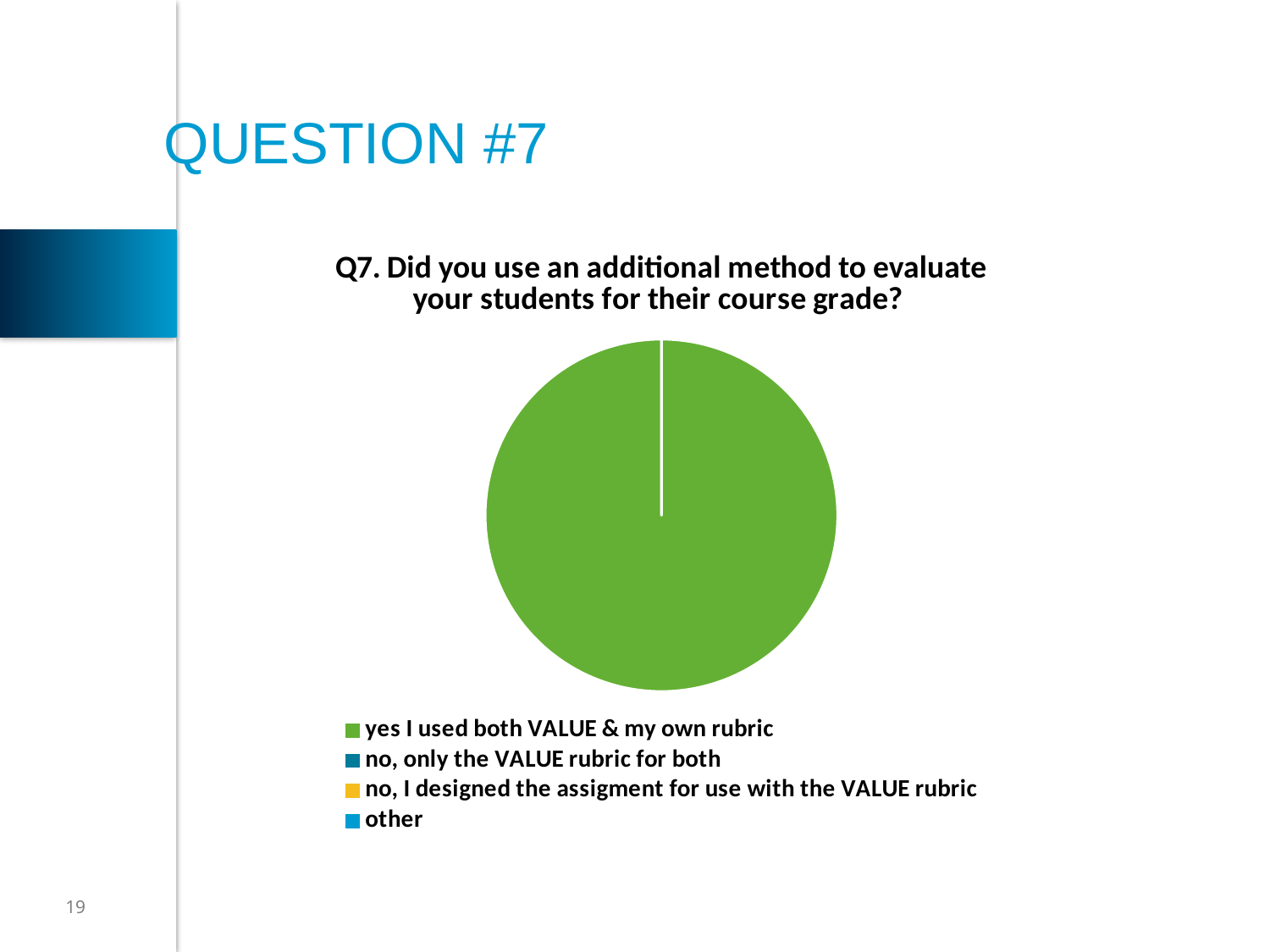
Which category is shown in green in the legend? yes I used both VALUE & my own rubric What is the title of the chart? Q7. Did you use an additional method to evaluate your students for their course grade? How many categories does the chart's legend list? 4 Which category has the largest slice of the pie? yes I used both VALUE & my own rubric How many slices are visible in the pie? 1 Which is larger: the slice for "yes I used both VALUE & my own rubric" or the slice for "other"? yes I used both VALUE & my own rubric Which is larger: the slice for "yes I used both VALUE & my own rubric" or the slice for "no, only the VALUE rubric for both"? yes I used both VALUE & my own rubric What kind of chart is shown on the slide? pie chart